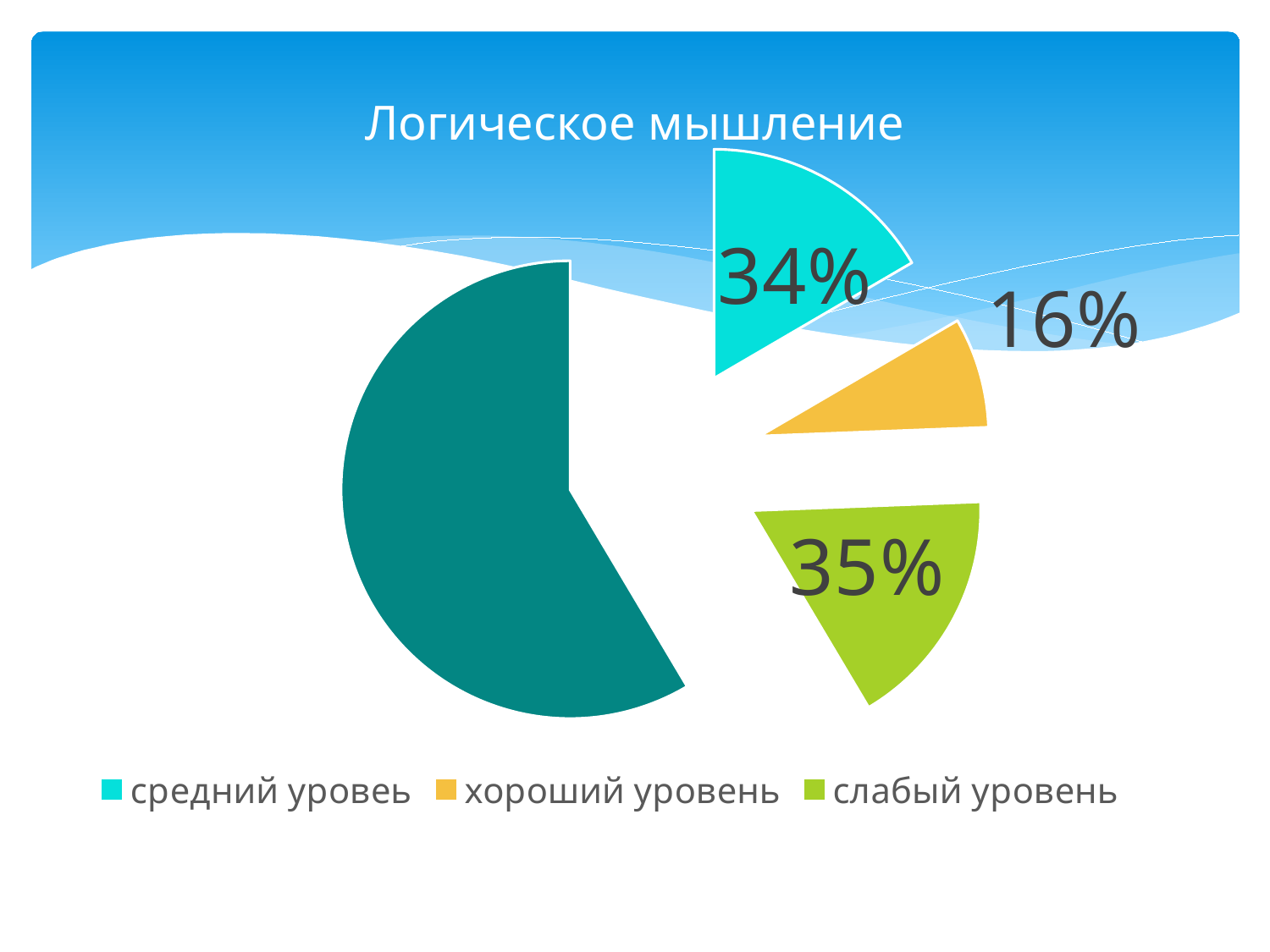
Which is larger, the share for 'средний уровеь' or for 'хороший уровень'? средний уровеь How many entries does the legend list? 3 What percentage is shown for the 'слабый уровень' slice? 35% By how many percentage points does 'средний уровеь' exceed 'хороший уровень'? 18 What colour is the 'хороший уровень' slice? Yellow Which legend category has the smallest labelled share of the pie? хороший уровень What percentage is shown for the 'средний уровеь' slice? 34% What percentage is shown for the 'хороший уровень' slice? 16% Which is larger, the share for 'слабый уровень' or for 'хороший уровень'? слабый уровень What kind of chart is shown on the slide? Pie chart What is the title of the chart? Логическое мышление By how many percentage points does 'слабый уровень' exceed 'хороший уровень'? 19